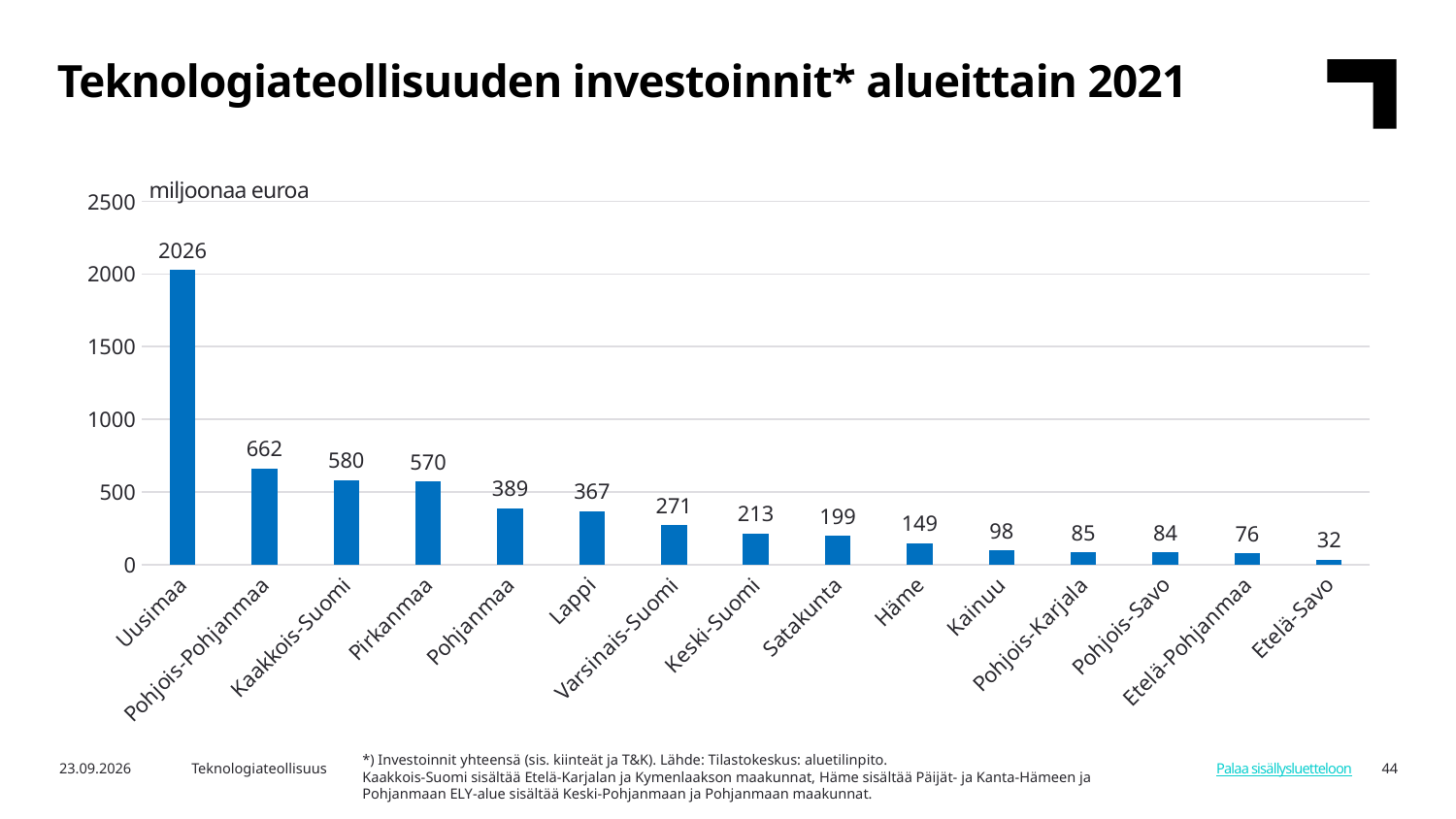
What unit is stated above the y axis of the chart? miljoonaa euroa Which region has the highest value? Uusimaa What is the difference between the values for Pohjois-Pohjanmaa and Kaakkois-Suomi? 82 Do the values rise or fall from left to right along the x axis? fall What kind of chart is shown on the slide? bar chart Which is larger, the value for Lappi or the value for Pohjanmaa? Pohjanmaa Which region has the lowest value? Etelä-Savo How many regions are shown in the chart? 15 What is the value for Satakunta? 199 Is the value for Varsinais-Suomi greater or less than 500? less What is the value for Pirkanmaa? 570 What is the value for Uusimaa? 2026